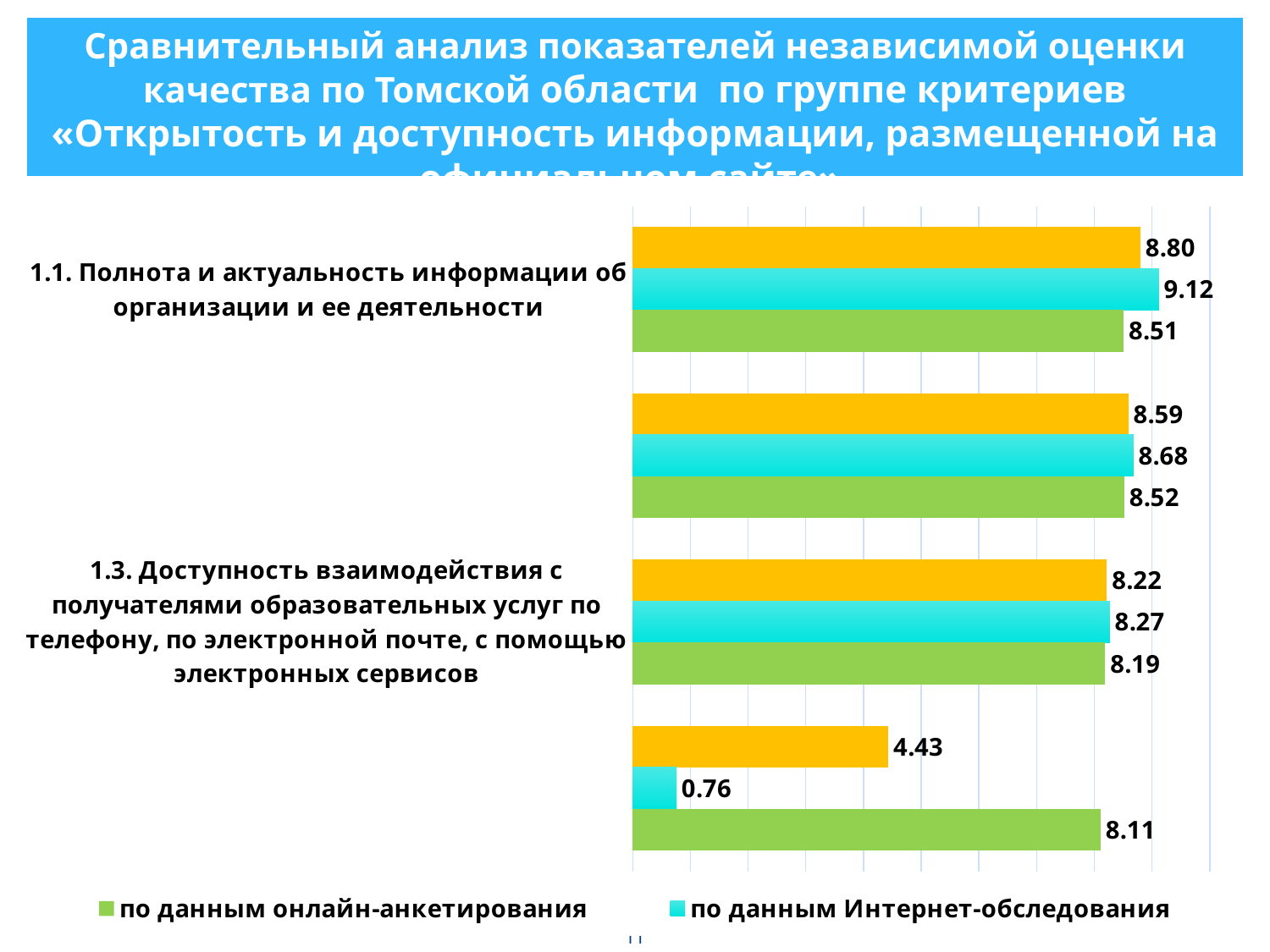
What is the value for «1.3. Доступность взаимодействия с получателями образовательных услуг...» in the series «по данным Интернет-обследования»? 8.27 What is the largest value printed on the chart? 9.12 What is the value for «1.1. Полнота и актуальность информации об организации и ее деятельности» in the series «по данным онлайн-анкетирования»? 8.51 What is the value for «1.1. Полнота и актуальность информации об организации и ее деятельности» in the series «по данным Интернет-обследования»? 9.12 In the series «по данным онлайн-анкетирования», which has the larger value: criterion 1.1 or criterion 1.3? 1.1 What type of chart is shown on the slide? Bar chart For criterion 1.1, how much higher is the value «по данным Интернет-обследования» than the value «по данным онлайн-анкетирования»? 0.61 For criterion 1.3, what is the difference between the value «по данным Интернет-обследования» and the value «по данным онлайн-анкетирования»? 0.08 What is the smallest value printed on the chart? 0.76 For criterion 1.1, which series has the higher value: «по данным онлайн-анкетирования» or «по данным Интернет-обследования»? по данным Интернет-обследования How many series does the legend list? 2 What is the value for «1.3. Доступность взаимодействия с получателями образовательных услуг...» in the series «по данным онлайн-анкетирования»? 8.19